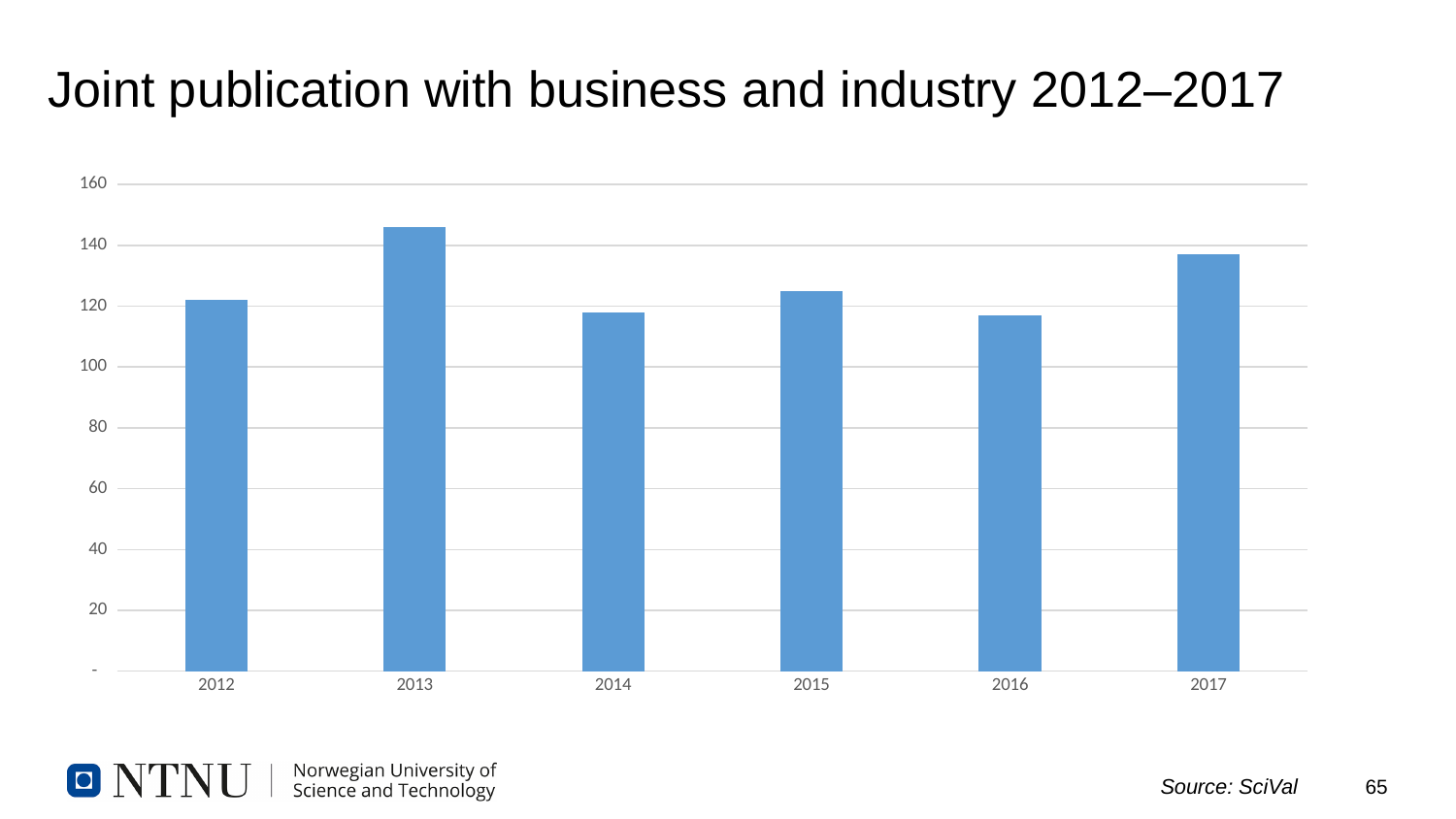
Does the value rise or fall from 2013 to 2014? fall Is the value for 2017 greater or less than 140? less What is the title of the chart on the slide? Joint publication with business and industry 2012–2017 Is the value for 2013 greater or less than 140? greater Is the value for 2012 greater or less than 140? less Which is larger, the value for 2017 or the value for 2015? 2017 What kind of chart is shown on the slide? bar chart How many years are shown on the x axis of the chart? 6 Which is larger, the value for 2013 or the value for 2012? 2013 Which year has the highest number of joint publications? 2013